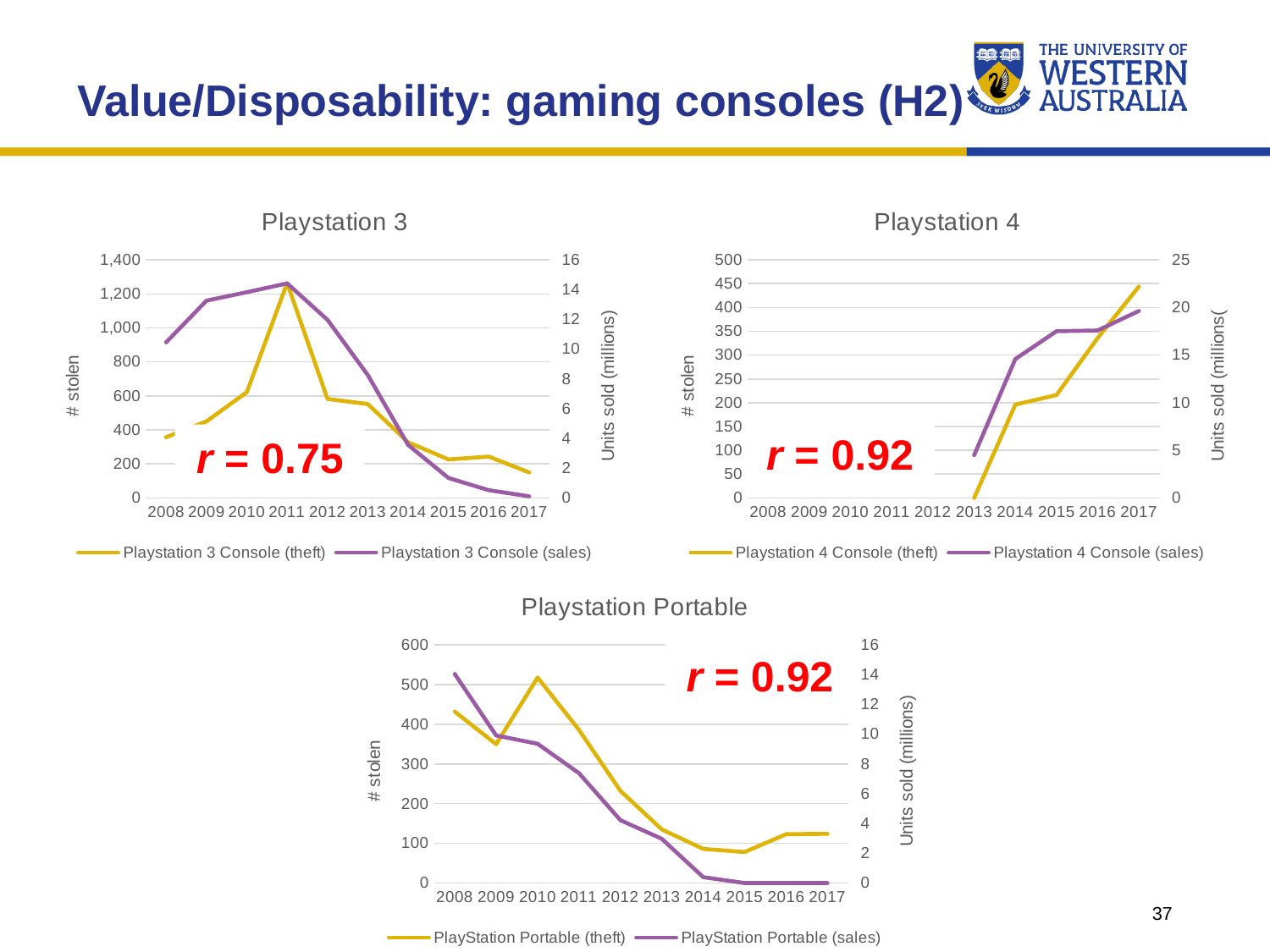
What correlation coefficient r is printed on the Playstation 3 chart? 0.75 In the Playstation Portable chart, which year has the highest value for PlayStation Portable (theft)? 2010 What type of chart is the Playstation 3 chart? line chart How many years are shown on the x axis of the Playstation Portable chart? 10 In the Playstation 3 chart, is the value for Playstation 3 Console (theft) in 2011 greater or less than 1,000? greater In the Playstation 4 chart, is the value for Playstation 4 Console (theft) in 2017 greater or less than 400? greater In the Playstation 3 chart, which year has the highest value for Playstation 3 Console (theft)? 2011 In the Playstation Portable chart, does PlayStation Portable (sales) rise or fall from 2008 to 2017? fall How many series does the legend of the Playstation 4 chart list? 2 In the Playstation 3 chart, is the value for Playstation 3 Console (sales) in 2017 greater or less than 2? less In the Playstation 4 chart, does Playstation 4 Console (sales) rise or fall from 2013 to 2017? rise In the Playstation 4 chart, which year has the highest value for Playstation 4 Console (theft)? 2017